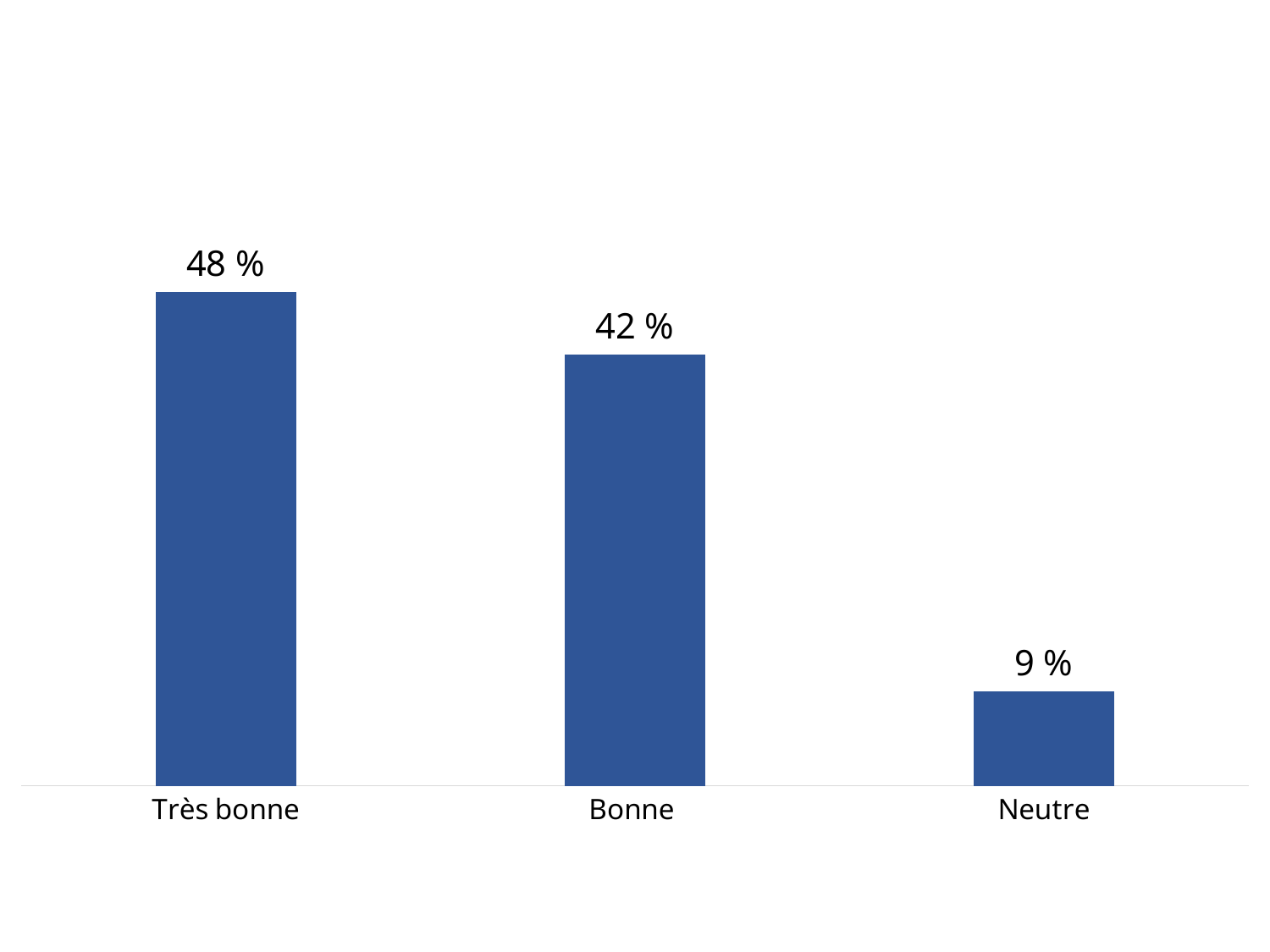
What is the difference between the values for Bonne and Neutre? 33 % Which category has the lowest value? Neutre How many categories are shown on the chart? 3 What colour are the bars? Blue Which category has the highest value? Très bonne What kind of chart is this? Bar chart Do the values rise or fall from left to right along the x axis? Fall What is the value for Très bonne? 48 % Which is larger, the value for Bonne or the value for Neutre? Bonne What is the value for Bonne? 42 % What is the value for Neutre? 9 % What is the difference between the values for Très bonne and Bonne? 6 %